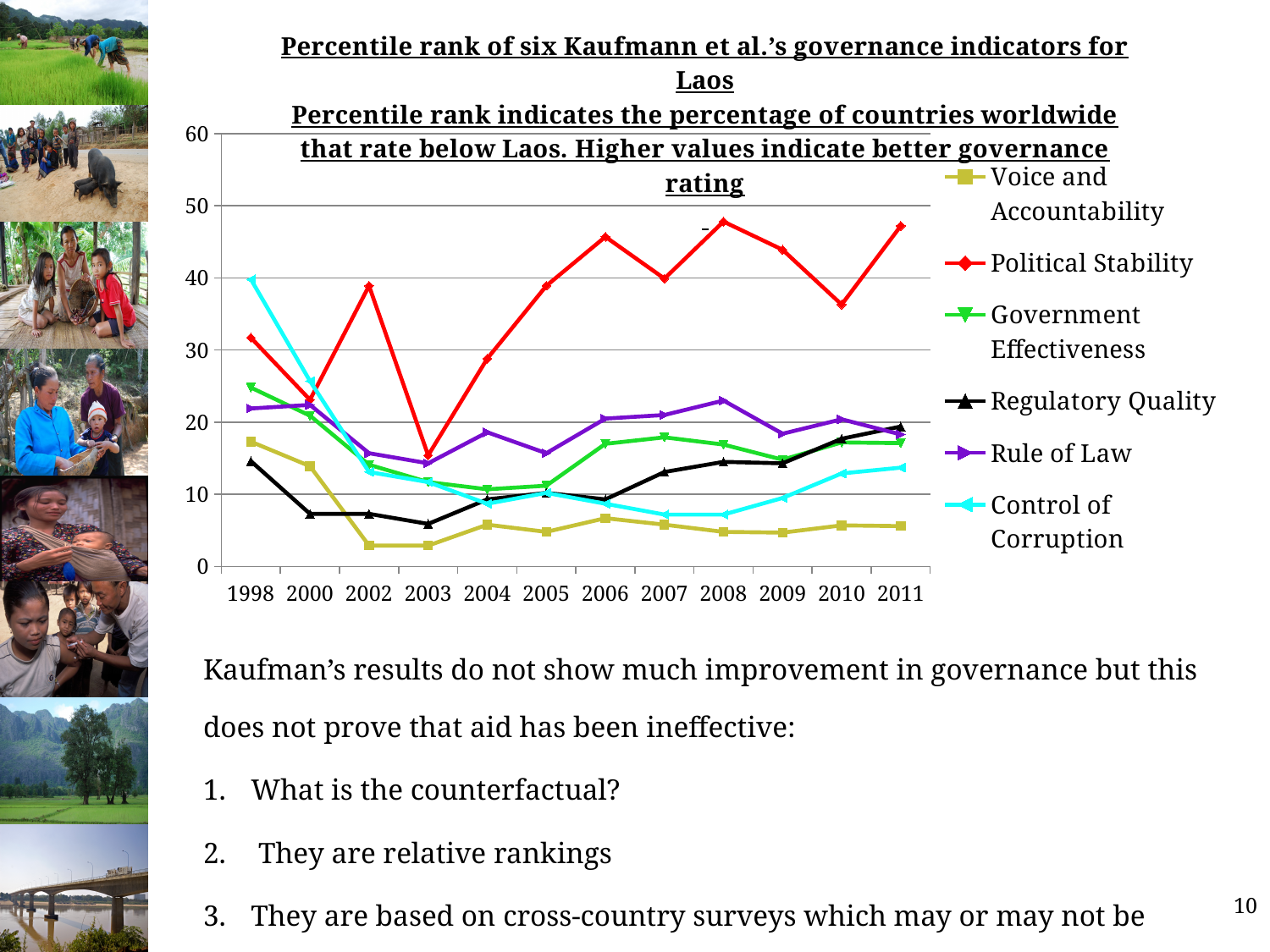
Which series has the lowest value in 2002? Voice and Accountability How many series does the legend list? 6 Is the value for Voice and Accountability in 2002 greater or less than 10? less Which series has the highest value in 2011? Political Stability Is the value for Political Stability in 2003 greater or less than 20? less Which colour is used for the Political Stability series? Red In 1998, which is larger: Control of Corruption or Political Stability? Control of Corruption In 2002, which is larger: Rule of Law or Regulatory Quality? Rule of Law Is the value for Political Stability in 2008 greater or less than 40? greater How many years are shown on the x axis? 12 Does the Political Stability line rise or fall from 2003 to 2006? rise What kind of chart is shown on the slide? Line chart